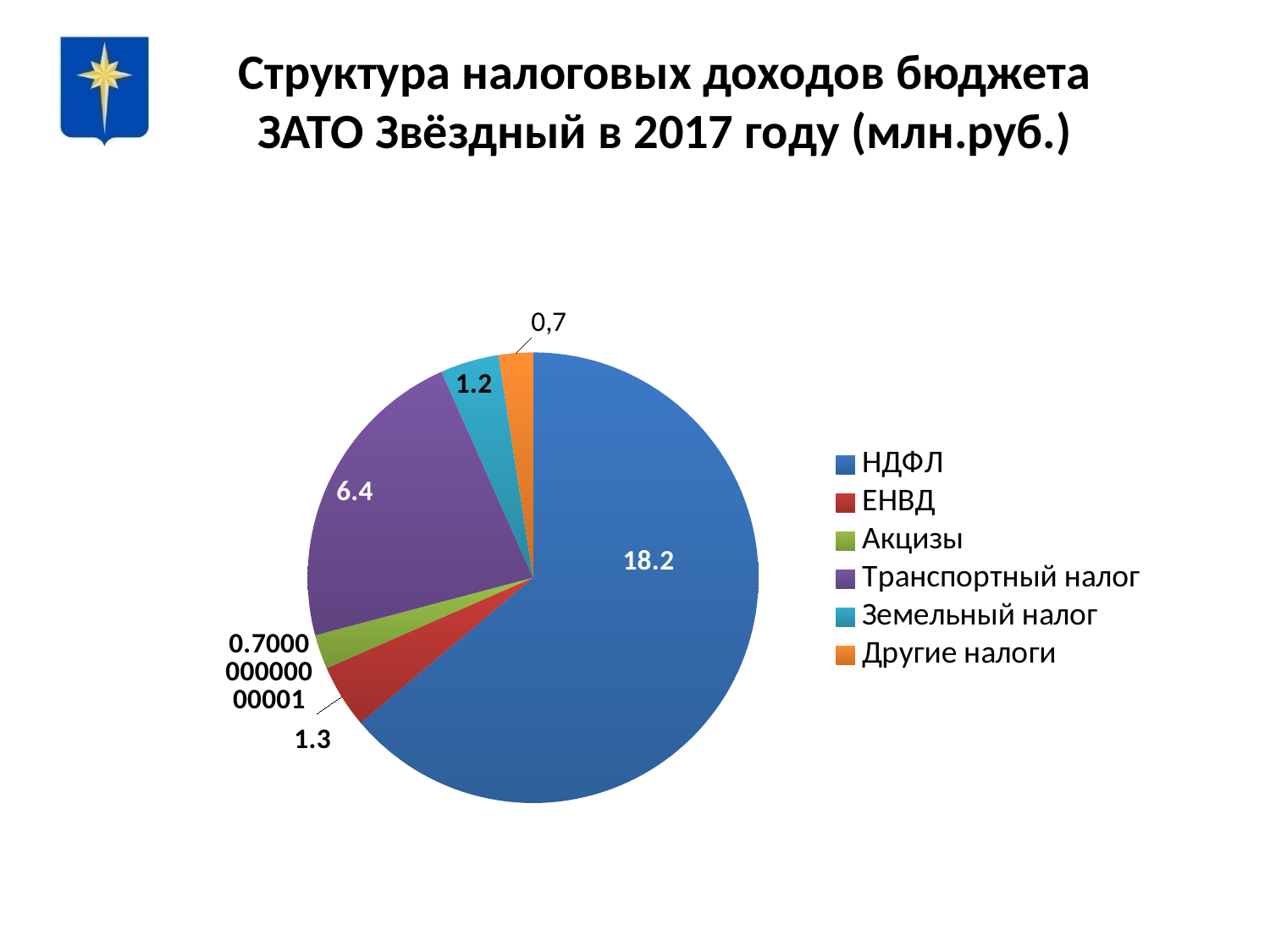
What is the value for Земельный налог? 1.2 Which category has the largest slice of the pie? НДФЛ What is the difference between the values for Транспортный налог and ЕНВД? 5.1 What is the value for Транспортный налог? 6.4 What is the value for НДФЛ? 18.2 What is the value for ЕНВД? 1.3 How many categories does the legend list? 6 Which is larger, the value for Транспортный налог or the value for ЕНВД? Транспортный налог What is the value for Другие налоги? 0,7 What type of chart is shown on the slide? pie chart What is the title of the chart? Структура налоговых доходов бюджета ЗАТО Звёздный в 2017 году (млн.руб.) What is the difference between the values for НДФЛ and Транспортный налог? 11.8